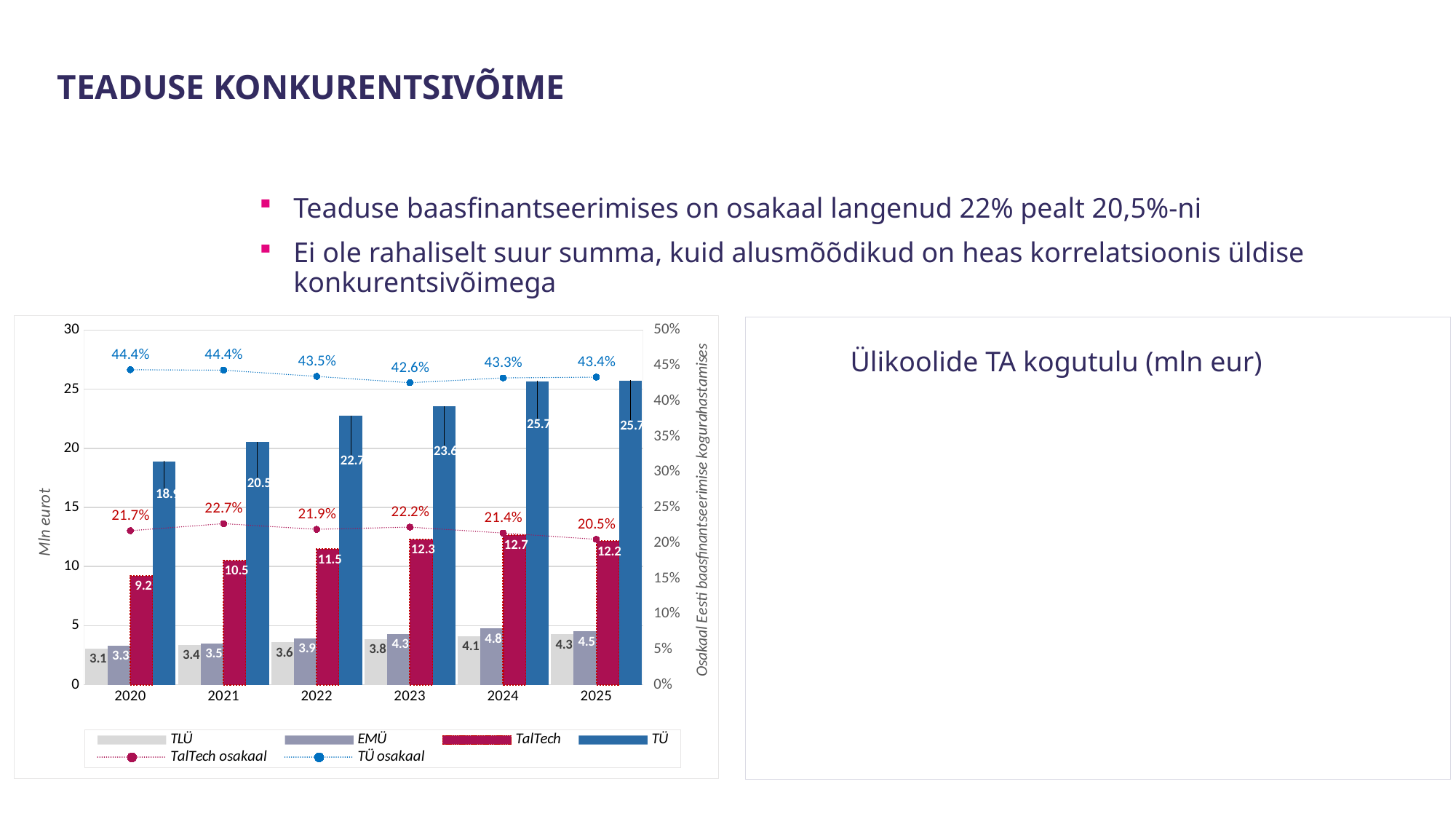
Which year has the larger EMÜ value, 2024 or 2025? 2024 How many years are shown on the x axis? 6 What is the value for TalTech in 2022? 11.5 What is the difference between the TÜ value in 2025 and in 2021? 5.2 Is the value for TÜ in 2020 greater or less than 15? greater In which year is the TalTech osakaal line highest? 2021 What kind of chart is shown? Bar chart with line series How many series does the legend list? 6 Do the TLÜ values rise or fall from 2020 to 2025? rise What is the TÜ osakaal value in 2023? 42.6% What is the value for EMÜ in 2023? 4.3 In which year is the TÜ osakaal line lowest? 2023